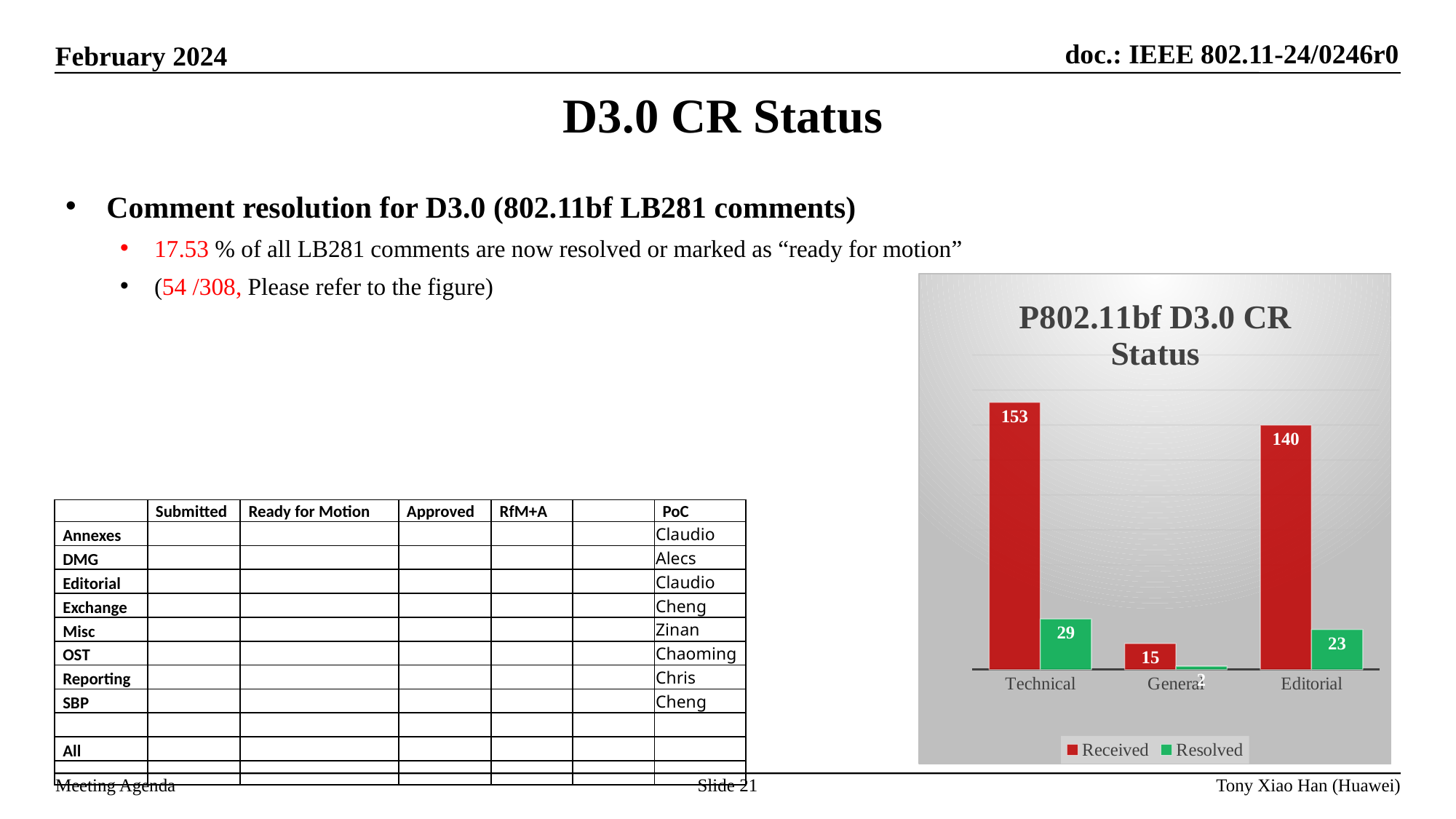
In the P802.11bf D3.0 CR Status chart, what is the Resolved value for Technical? 29 What kind of chart is the P802.11bf D3.0 CR Status chart? Bar chart In the P802.11bf D3.0 CR Status chart, what is the Resolved value for Editorial? 23 In the P802.11bf D3.0 CR Status chart, what is the Received value for General? 15 In the P802.11bf D3.0 CR Status chart, what is the Received value for Technical? 153 How many categories are shown on the x axis of the P802.11bf D3.0 CR Status chart? 3 In the P802.11bf D3.0 CR Status chart, which category has the highest Received value? Technical How many series does the legend of the P802.11bf D3.0 CR Status chart list? 2 In the P802.11bf D3.0 CR Status chart, what is the Received value for Editorial? 140 In the P802.11bf D3.0 CR Status chart, what is the difference between the Received values for Technical and Editorial? 13 In the P802.11bf D3.0 CR Status chart, which is larger: the Resolved value for Technical or the Resolved value for Editorial? Technical In the P802.11bf D3.0 CR Status chart, which category has the lowest Received value? General